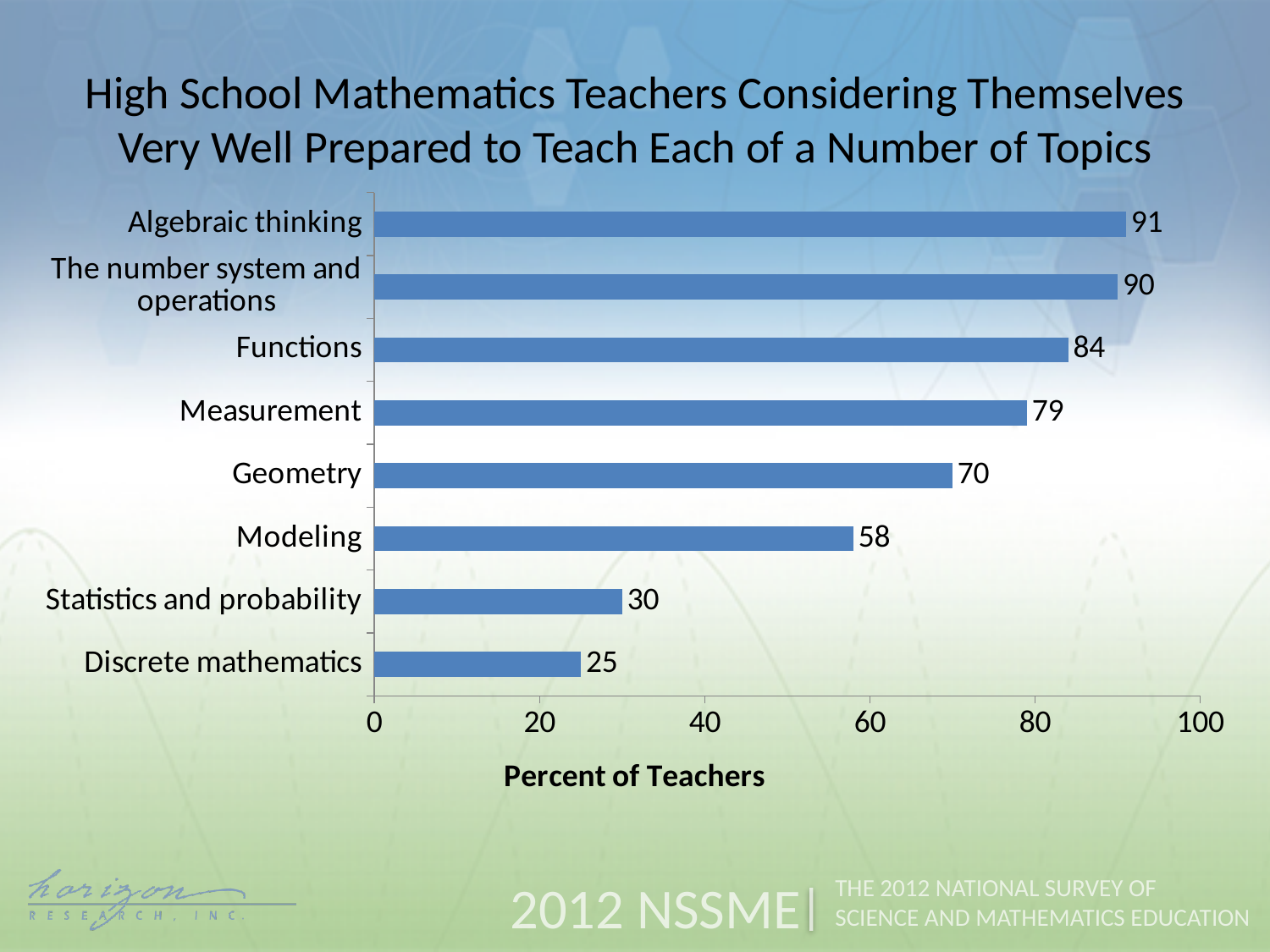
Which topic has the lowest percent of teachers? Discrete mathematics What is the label of the horizontal axis? Percent of Teachers Is the value for Modeling greater or less than 60? less What is the difference between the values for Functions and Modeling? 26 What is the value for Statistics and probability? 30 Which is larger, the value for Measurement or the value for Geometry? Measurement How many topics are shown in the chart? 8 What kind of chart is shown on the slide? bar chart Which topic has the highest percent of teachers? Algebraic thinking What percent of teachers consider themselves very well prepared to teach Algebraic thinking? 91 What is the difference between the values for The number system and operations and Discrete mathematics? 65 What is the value for Geometry? 70